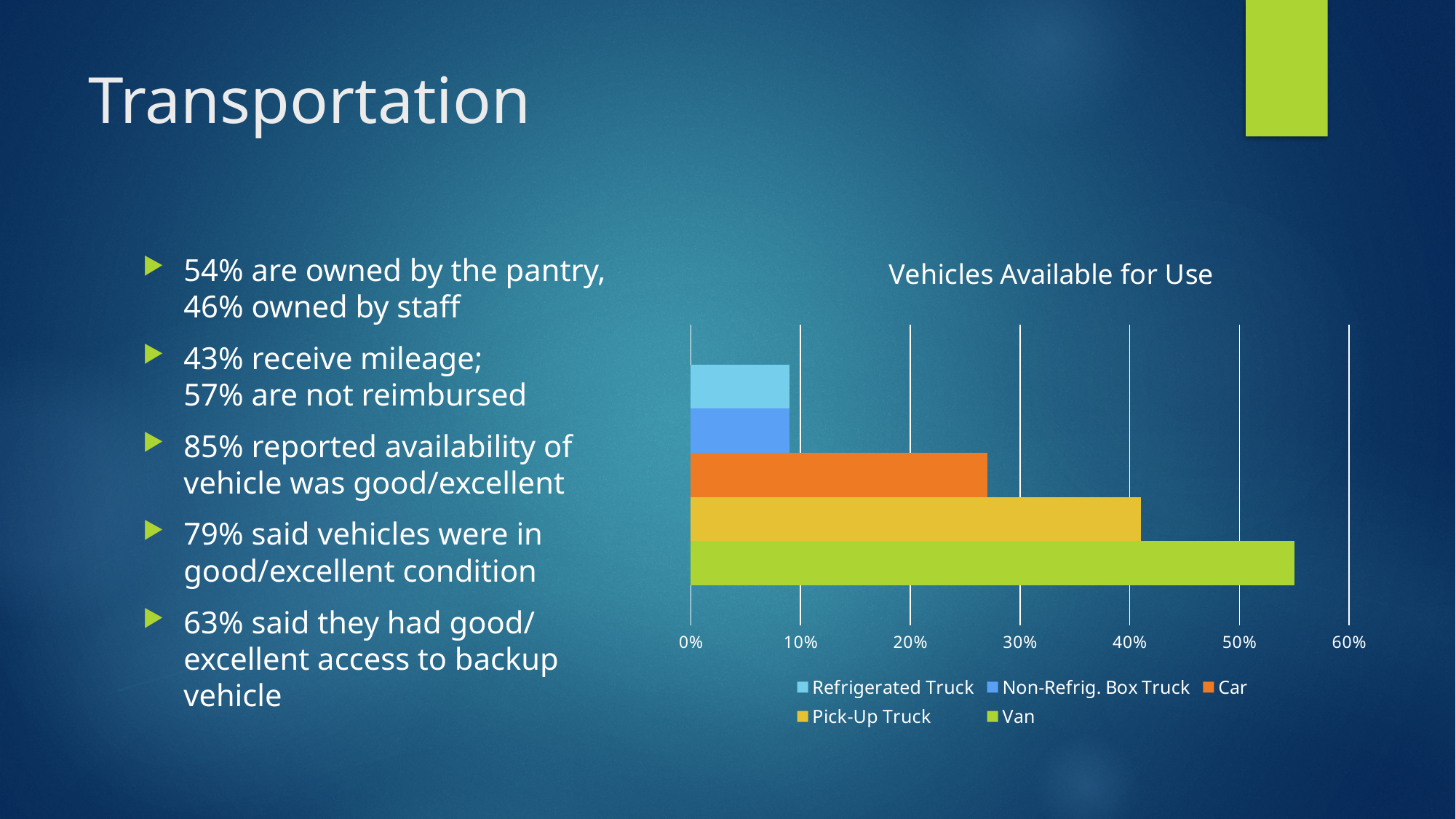
What is the title of the chart? Vehicles Available for Use Is the value for Non-Refrig. Box Truck greater or less than 20%? less Which vehicle type has the highest value in the chart? Van How many series does the chart legend list? 5 What colour is the bar for Car in the chart? orange Which is larger, the value for Pick-Up Truck or the value for Refrigerated Truck? Pick-Up Truck Is the value for Van greater or less than 50%? greater Is the value for Car greater or less than 30%? less Which is larger, the value for Van or the value for Car? Van What kind of chart is shown on the slide? bar chart